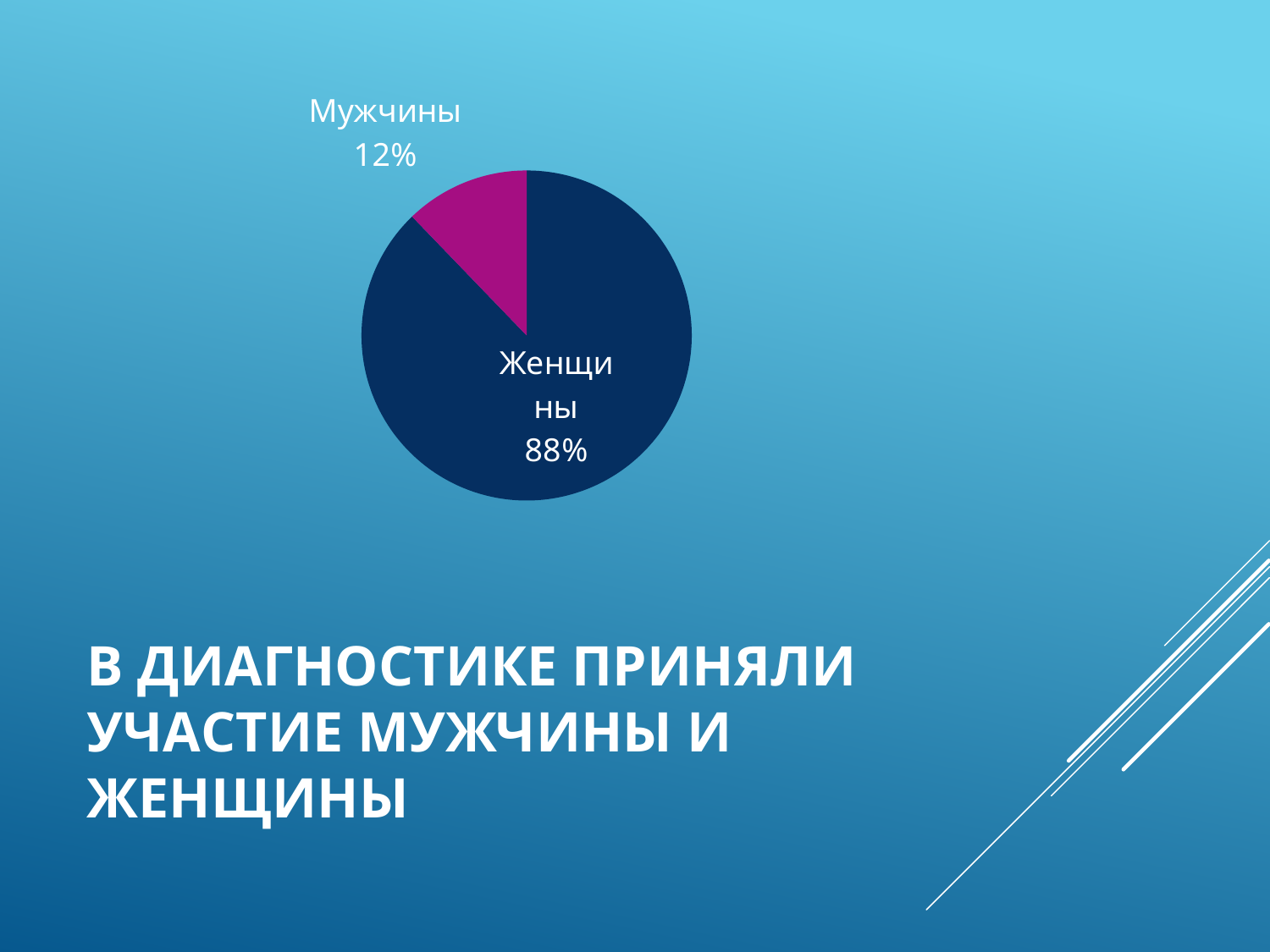
What kind of chart is shown on the slide? Pie chart What share of the pie chart is labelled Женщины? 88% What is the total of the two slices shown in the pie chart? 100% What share of the pie chart is labelled Мужчины? 12% How many slices does the pie chart have? 2 Which category has the smallest slice in the pie chart? Мужчины Which category has the largest slice in the pie chart? Женщины What colour is the Мужчины slice in the pie chart? Magenta What is the difference in percentage points between the Женщины and Мужчины slices? 76 Which slice is larger, Мужчины or Женщины? Женщины What colour is the Женщины slice in the pie chart? Dark blue